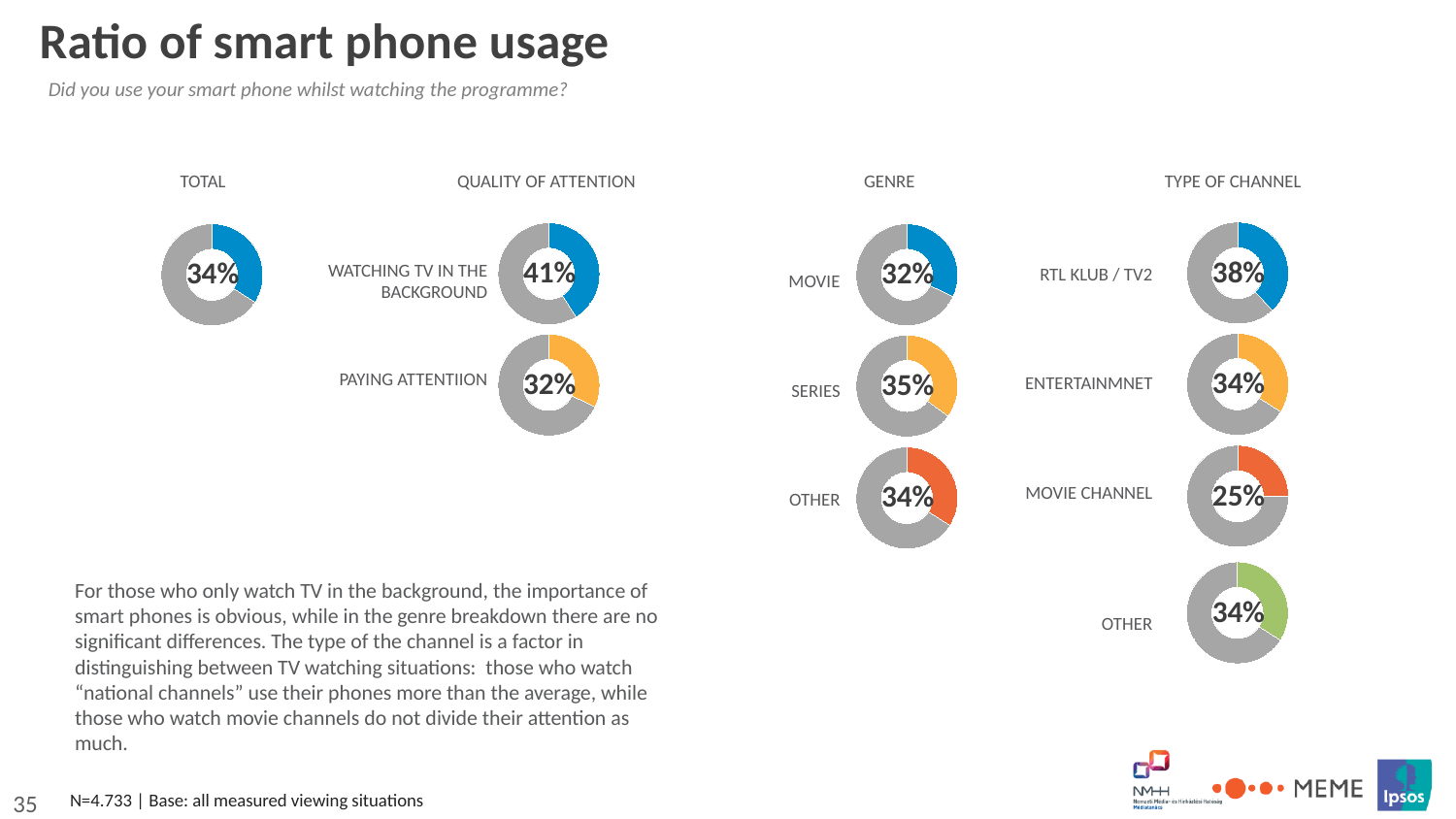
In the TYPE OF CHANNEL charts, what is the value for RTL Klub / TV2? 38% In the TOTAL donut chart, what is the ratio of smart phone usage shown? 34% In the QUALITY OF ATTENTION charts, what is the difference between Watching TV in the background and Paying attention? 9% In the TYPE OF CHANNEL charts, what is the difference between RTL Klub / TV2 and Movie channel? 13% In the TYPE OF CHANNEL charts, which category has the lowest value? Movie channel In the GENRE charts, what is the value for Series? 35% In the TYPE OF CHANNEL charts, how many categories are shown? 4 In the QUALITY OF ATTENTION charts, what is the value for Watching TV in the background? 41% What kind of chart is used to show the values on this slide? Donut (pie) chart In the GENRE charts, how many categories are shown? 3 In the GENRE charts, which category has the lowest value? Movie In the QUALITY OF ATTENTION charts, what is the value for Paying attention? 32%